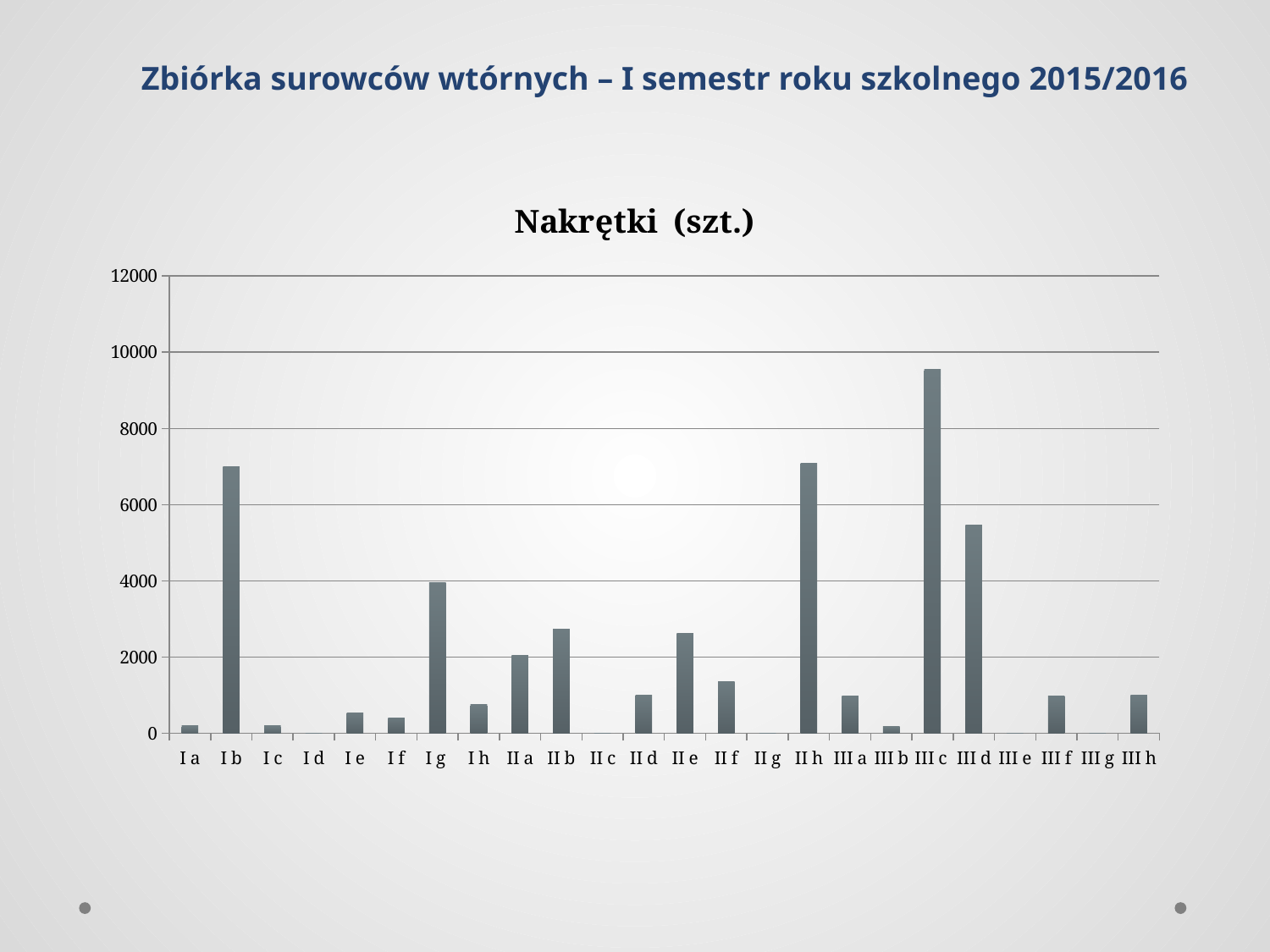
Which is larger, the value for I b or the value for I g? I b Which is larger, the value for I g or the value for II b? I g What is the title of the chart? Nakrętki (szt.) Is the value for II b greater or less than 2000? greater How many categories (classes) are shown on the x axis of the chart? 24 Is the value for I b greater or less than 8000? less Is the value for III d greater or less than 6000? less Which class has the highest value in the chart? III c What kind of chart is shown on the slide? bar chart Which is larger, the value for III c or the value for III d? III c